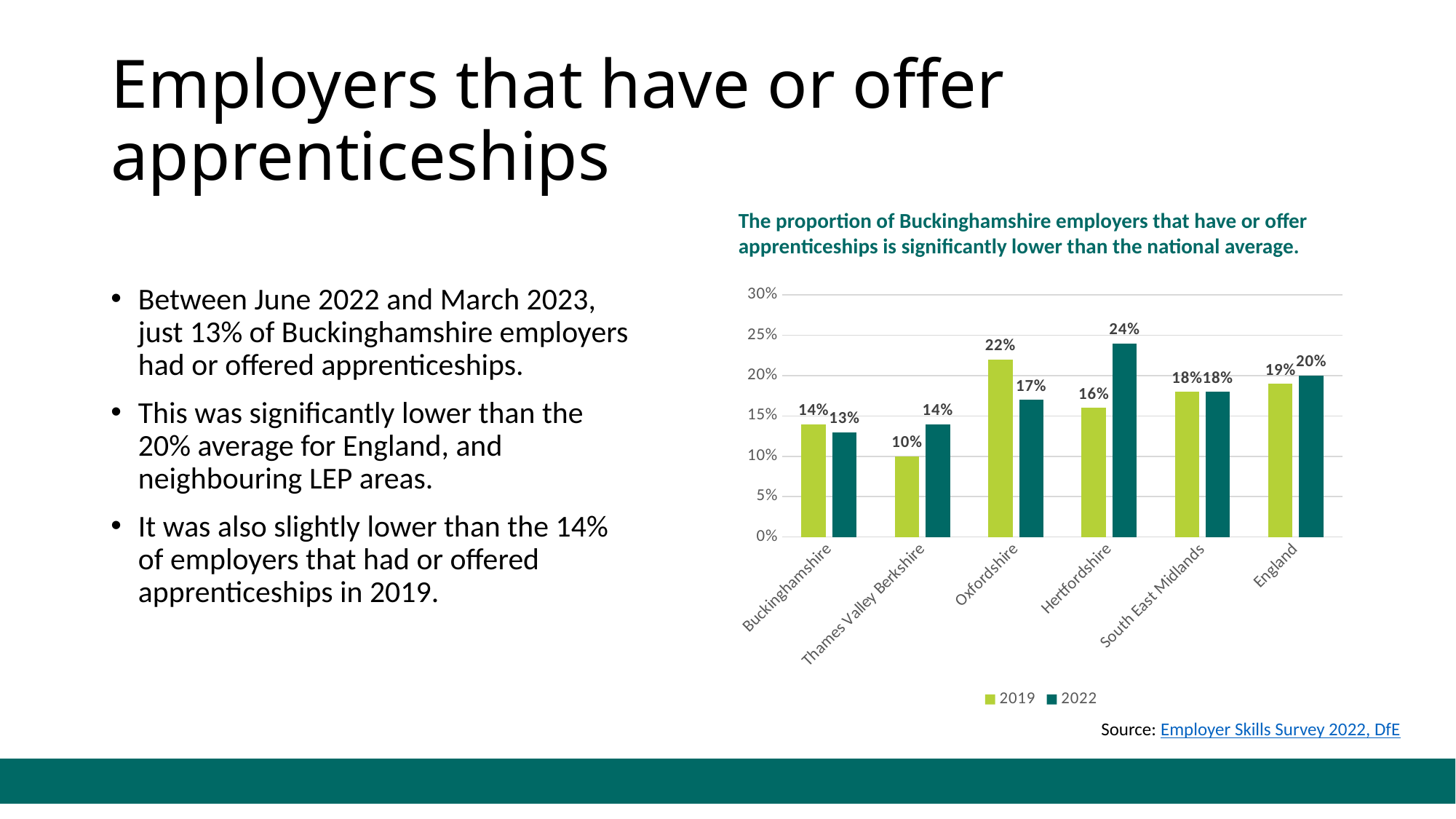
What is the 2019 value for Thames Valley Berkshire? 10% What is the 2022 value for Hertfordshire? 24% How many series does the legend list? 2 What is the 2022 value for Buckinghamshire? 13% What is the difference between the 2022 values for England and Buckinghamshire? 7% Which is larger for Oxfordshire, the 2019 value or the 2022 value? 2019 Which series is shown in dark green in the legend? 2022 Which area has the highest 2022 value? Hertfordshire Which area has the lowest 2019 value? Thames Valley Berkshire What kind of chart is shown? Bar chart What is the difference between the 2019 and 2022 values for Hertfordshire? 8% How many areas are shown on the x axis? 6